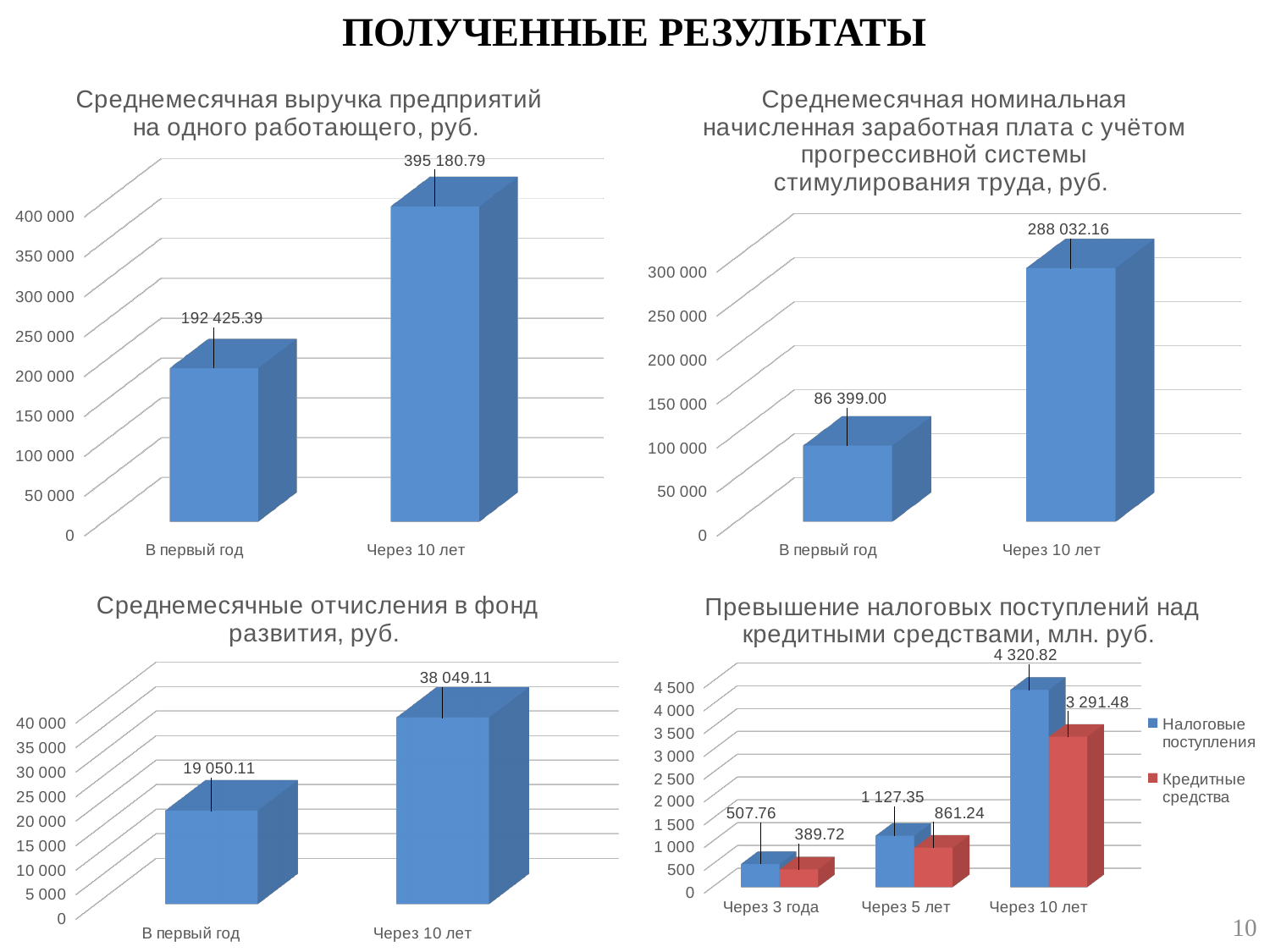
On the top-right chart (Среднемесячная номинальная начисленная заработная плата), which category has the highest value? Через 10 лет On the bottom-right chart (Превышение налоговых поступлений над кредитными средствами), what is the value of Налоговые поступления for Через 5 лет? 1 127.35 On the bottom-right chart (Превышение налоговых поступлений над кредитными средствами), what is the value of Кредитные средства for Через 3 года? 389.72 On the top-left chart (Среднемесячная выручка предприятий на одного работающего), what is the value for В первый год? 192 425.39 On the top-right chart (Среднемесячная номинальная начисленная заработная плата), what is the value for В первый год? 86 399.00 On the bottom-left chart (Среднемесячные отчисления в фонд развития), what is the difference between the value for Через 10 лет and the value for В первый год? 18 999.00 On the top-left chart (Среднемесячная выручка предприятий на одного работающего), what is the value for Через 10 лет? 395 180.79 On the bottom-right chart (Превышение налоговых поступлений над кредитными средствами), how many series does the legend list? 2 What kind of chart is the top-left chart (Среднемесячная выручка предприятий на одного работающего)? Bar chart On the bottom-left chart (Среднемесячные отчисления в фонд развития), what is the value for Через 10 лет? 38 049.11 On the bottom-right chart (Превышение налоговых поступлений над кредитными средствами), what is the difference between Налоговые поступления and Кредитные средства for Через 10 лет? 1 029.34 On the top-left chart (Среднемесячная выручка предприятий на одного работающего), what is the difference between the value for Через 10 лет and the value for В первый год? 202 755.40